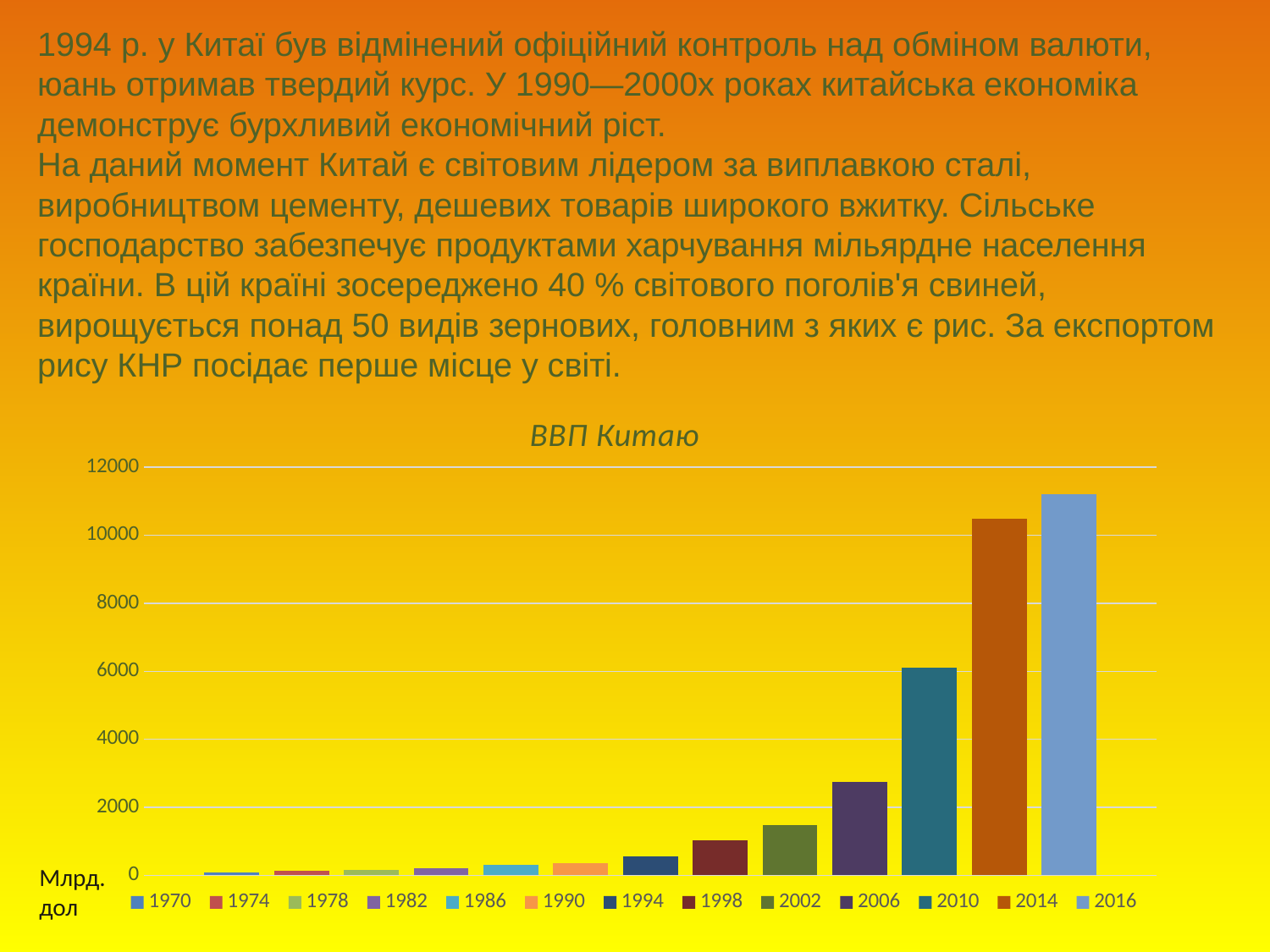
Is the value for 2016 greater or less than 10000? greater What kind of chart is shown on the slide? bar chart How many entries does the chart legend list? 13 Do the values rise or fall from 1970 to 2016? rise Which year has the lowest value in the chart? 1970 Which year has the highest value in the chart? 2016 What is the title of the chart? ВВП Китаю Is the value for 2002 greater or less than 2000? less Which is larger, the value for 2014 or the value for 2010? 2014 Is the value for 2014 greater or less than 8000? greater Which is larger, the value for 2006 or the value for 1998? 2006